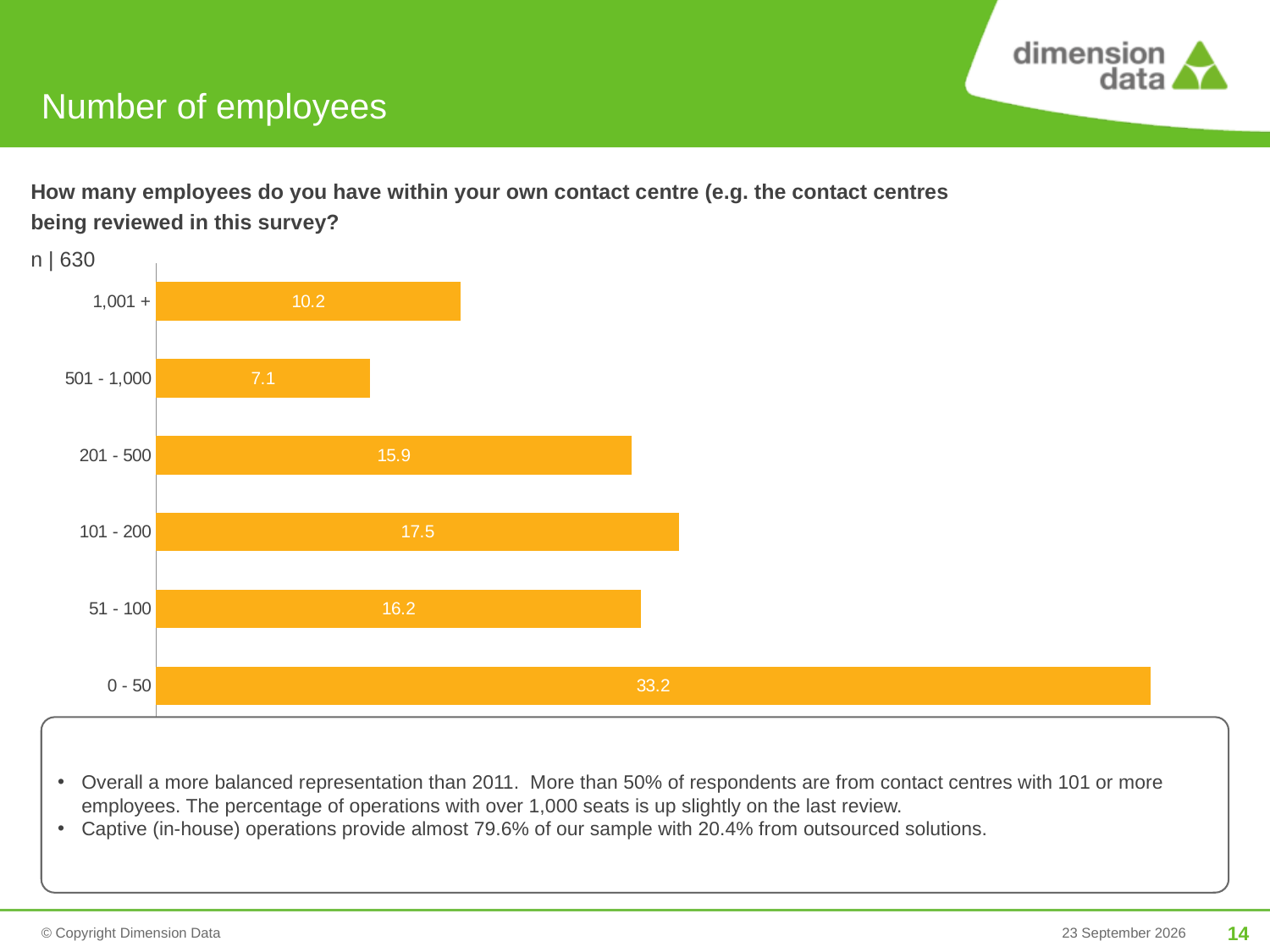
Which category has the lowest value? 501 - 1,000 What kind of chart is shown on the slide? Bar chart What is the value for the 101 - 200 category? 17.5 Which is larger, the value for 101 - 200 or the value for 201 - 500? 101 - 200 What is the difference between the values for 0 - 50 and 51 - 100? 17.0 What is the difference between the values for 201 - 500 and 501 - 1,000? 8.8 What is the value for the 0 - 50 category? 33.2 What is the value for the 501 - 1,000 category? 7.1 What is the value for the 1,001 + category? 10.2 Which category has the highest value? 0 - 50 How many categories are shown in the chart? 6 What sample size (n) is shown above the chart? 630